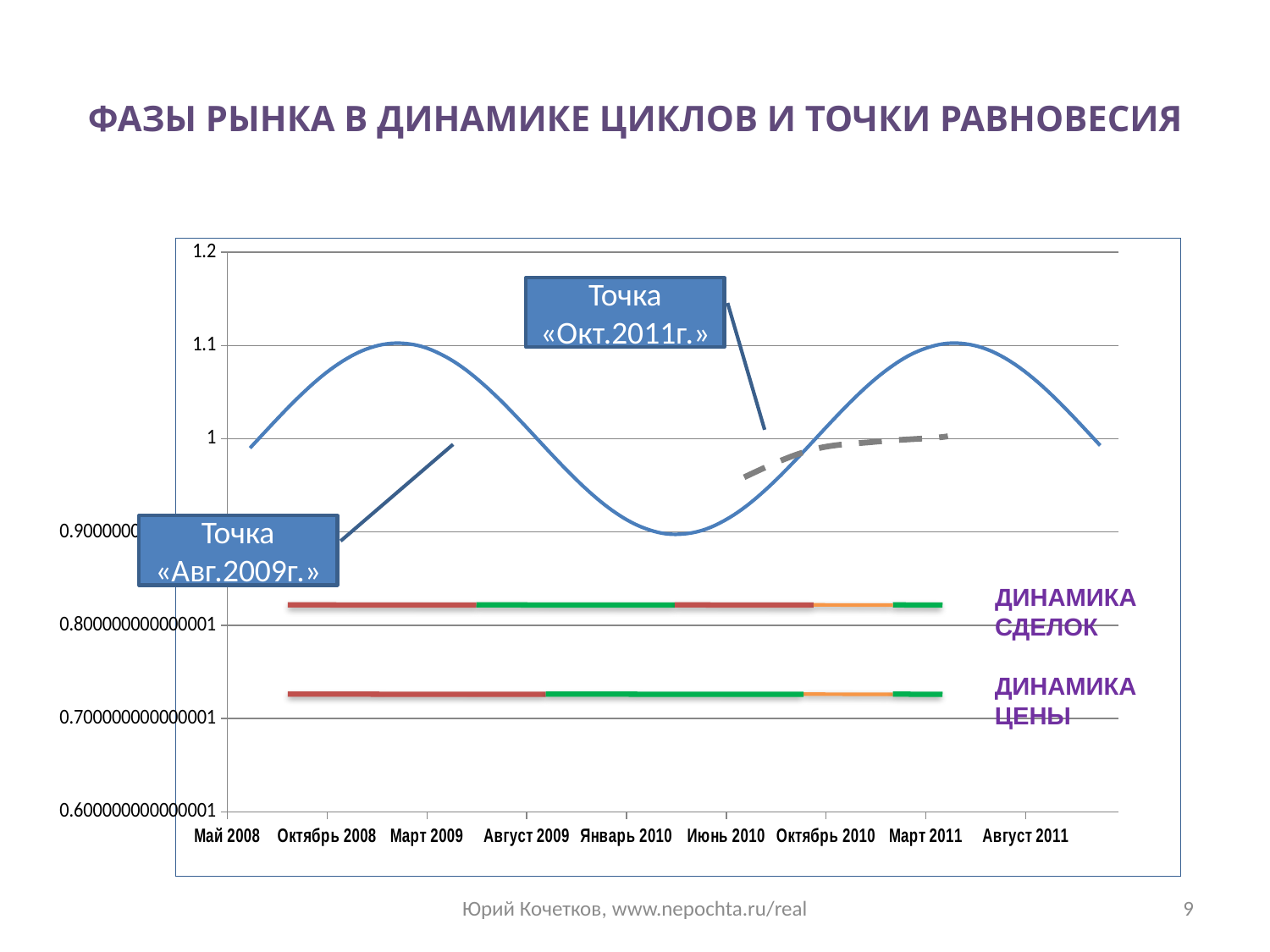
How many category labels are shown along the x axis of the chart? 9 What kind of chart is shown on the slide? line chart Is the value of the blue curve at Март 2009 greater or less than 1.2? less What is the first category label on the x axis? Май 2008 Is the value of the blue curve at Март 2011 greater or less than 1? greater Which is larger on the blue curve: the value at Март 2009 or the value at Январь 2010? Март 2009 What is the title of the slide containing the chart? ФАЗЫ РЫНКА В ДИНАМИКЕ ЦИКЛОВ И ТОЧКИ РАВНОВЕСИЯ Does the blue curve rise or fall between Март 2009 and Январь 2010? fall Is the value of the blue curve at Март 2009 greater or less than 1? greater What is the highest tick value shown on the y axis? 1.2 Does the blue curve rise or fall between Май 2008 and Март 2009? rise